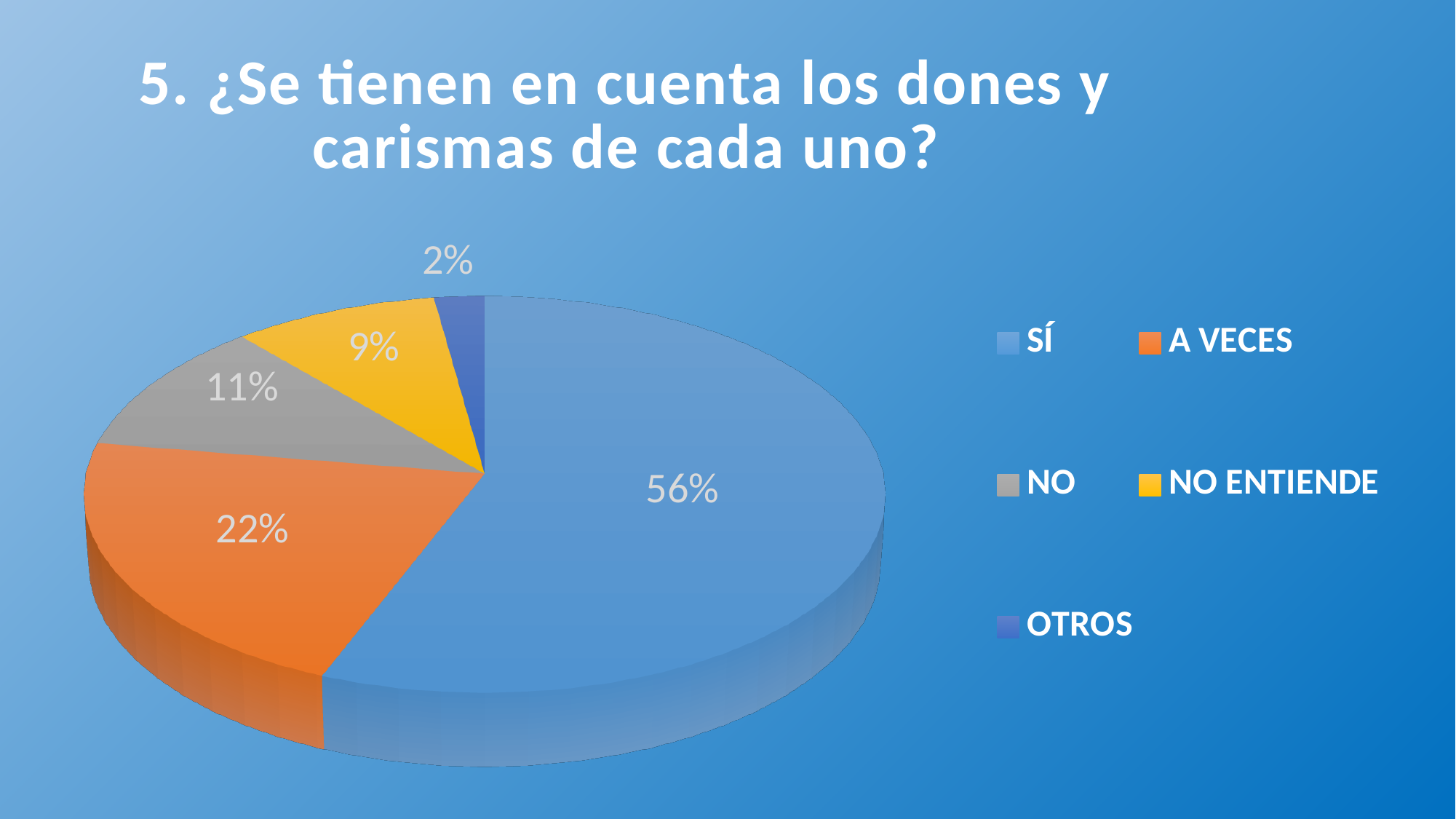
How many categories does the legend list? 5 Which category has the smallest slice of the pie? OTROS What percentage is shown for NO ENTIENDE? 9% What percentage of the pie does the SÍ slice represent? 56% What is the difference in percentage points between SÍ and A VECES? 34 What kind of chart is shown on the slide? pie chart What colour is the A VECES slice? orange What percentage is shown for NO? 11% What percentage is shown for A VECES? 22% Which is larger, the NO slice or the NO ENTIENDE slice? NO What percentage is shown for OTROS? 2% Which category has the largest slice of the pie? SÍ